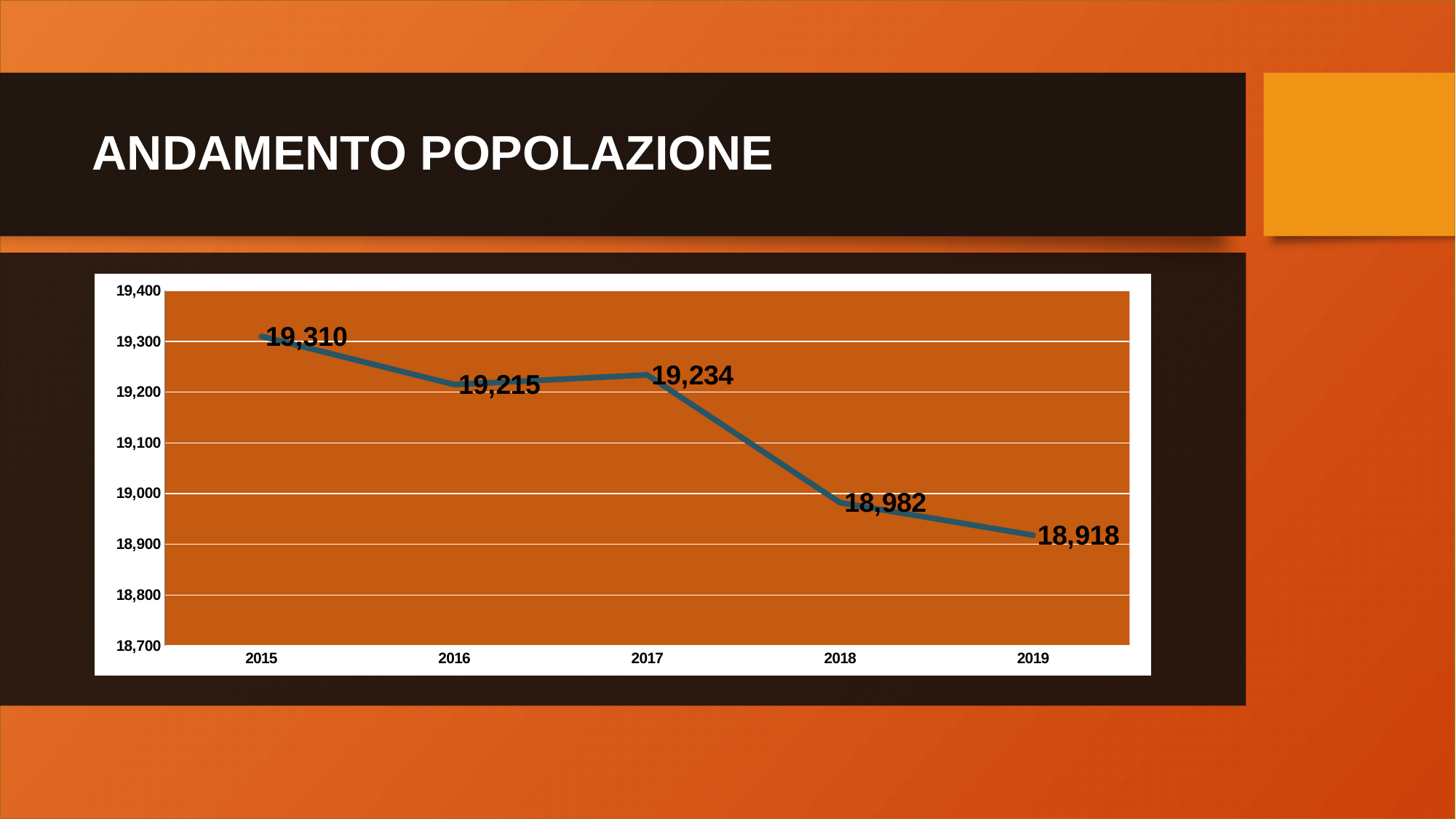
What is the population value for 2019? 18,918 What is the difference between the population in 2017 and in 2018? 252 Which year has the highest population value? 2015 What is the population value for 2017? 19,234 Is the value for 2018 greater or less than 19,000? less What kind of chart is shown on the slide? line chart Which year has the lowest population value? 2019 How many years are plotted on the chart? 5 What is the title of the slide containing the chart? ANDAMENTO POPOLAZIONE Which year has the larger population value, 2016 or 2017? 2017 What is the difference between the population in 2015 and in 2019? 392 What is the population value for 2015? 19,310